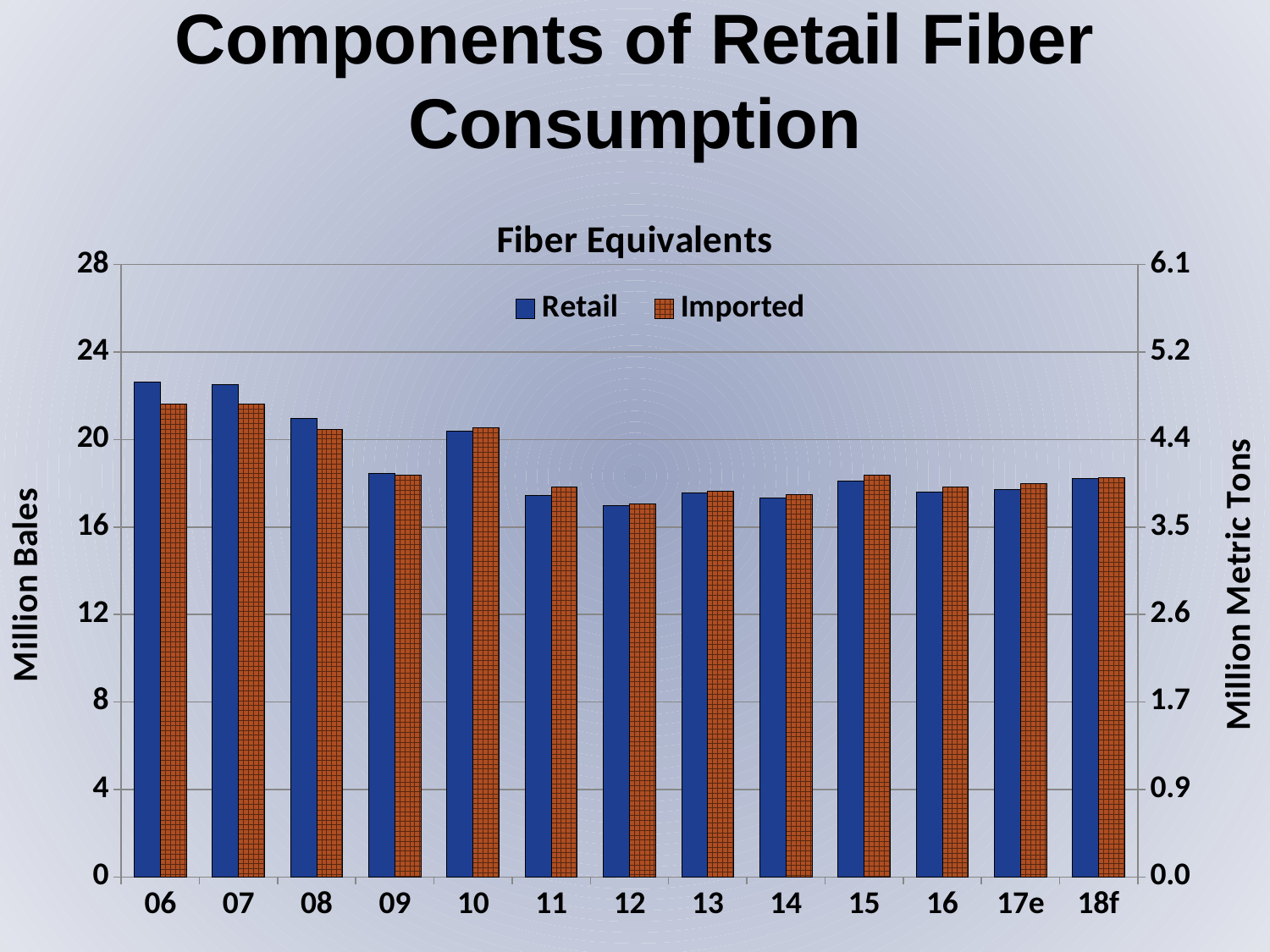
Which year has the lowest Retail value? 12 For 06, which is larger, the Retail bar or the Imported bar? Retail What is the label on the left vertical axis? Million Bales How many year categories are shown on the x axis? 13 Is the Retail value for 06 greater or less than 20 million bales? greater Is the Imported value for 09 greater or less than 20 million bales? less Is the Retail value for 11 greater or less than 20 million bales? less What kind of chart is shown on the slide? bar chart Which is larger, the Retail value for 08 or the Retail value for 12? 08 How many series does the legend list? 2 Do the Retail values generally rise or fall from 06 to 12? fall